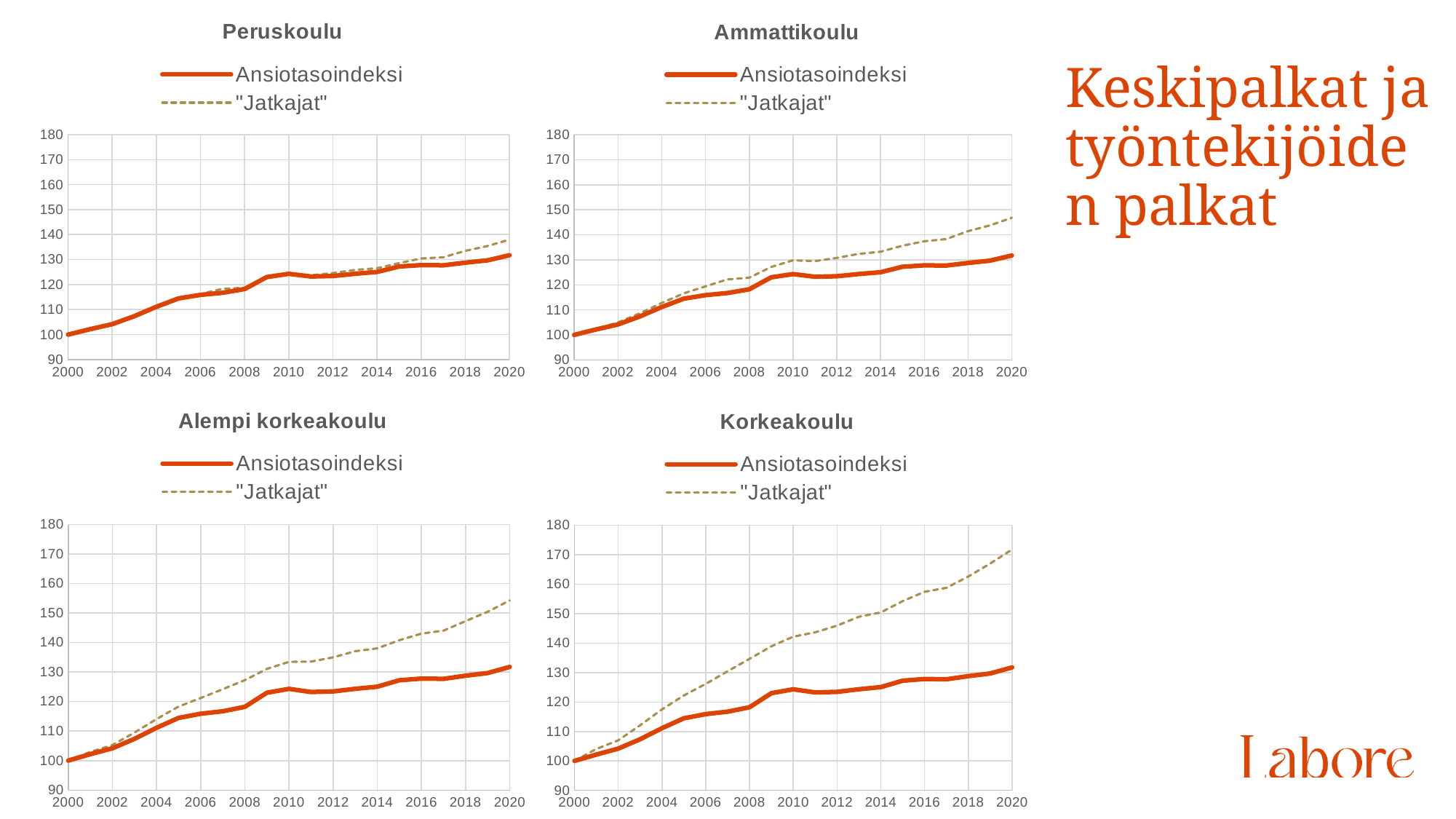
In the Peruskoulu chart, what is the value of Ansiotasoindeksi in 2000? 100 In the Korkeakoulu chart, is the value of "Jatkajat" in 2020 greater or less than 160? greater In the Korkeakoulu chart, does the "Jatkajat" series rise or fall from 2000 to 2020? rise What kind of chart is the Peruskoulu chart? line chart In the Ammattikoulu chart, is the value of "Jatkajat" in 2020 greater or less than 140? greater In the Alempi korkeakoulu chart, is the value of "Jatkajat" in 2020 greater or less than 140? greater Which of the four charts shows the largest gap between "Jatkajat" and Ansiotasoindeksi in 2020? Korkeakoulu In the Korkeakoulu chart, which series has the higher value in 2020, Ansiotasoindeksi or "Jatkajat"? "Jatkajat" How many series does the legend of the Korkeakoulu chart list? 2 How many charts are shown on the slide? 4